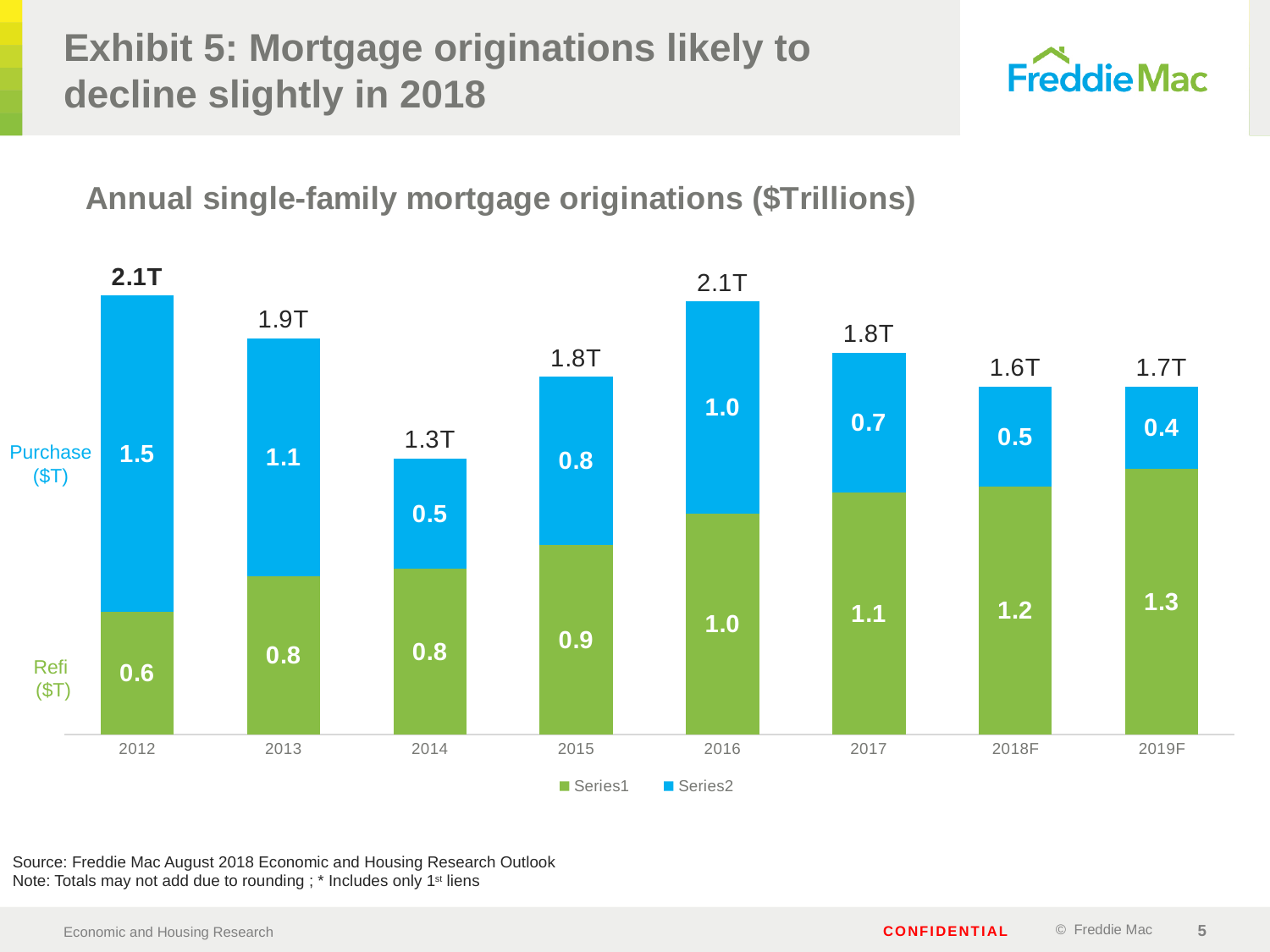
Which is larger, the Refi value for 2017 or the Purchase value for 2017? Refi (1.1) What is the Purchase value for 2016? 1.0 What is the difference between the Purchase value in 2012 and the Purchase value in 2013? 0.4 How many series does the legend list? 2 What is the total labeled above the 2014 bar? 1.3T What is the Refi value for 2012? 0.6 Which year has the highest Purchase value? 2012 Which year has the lowest Refi value? 2012 Do the Refi values rise or fall from 2015 to 2019F? Rise How many years are shown on the x axis? 8 What kind of chart is shown? Stacked bar chart What is the Purchase value for 2019F? 0.4